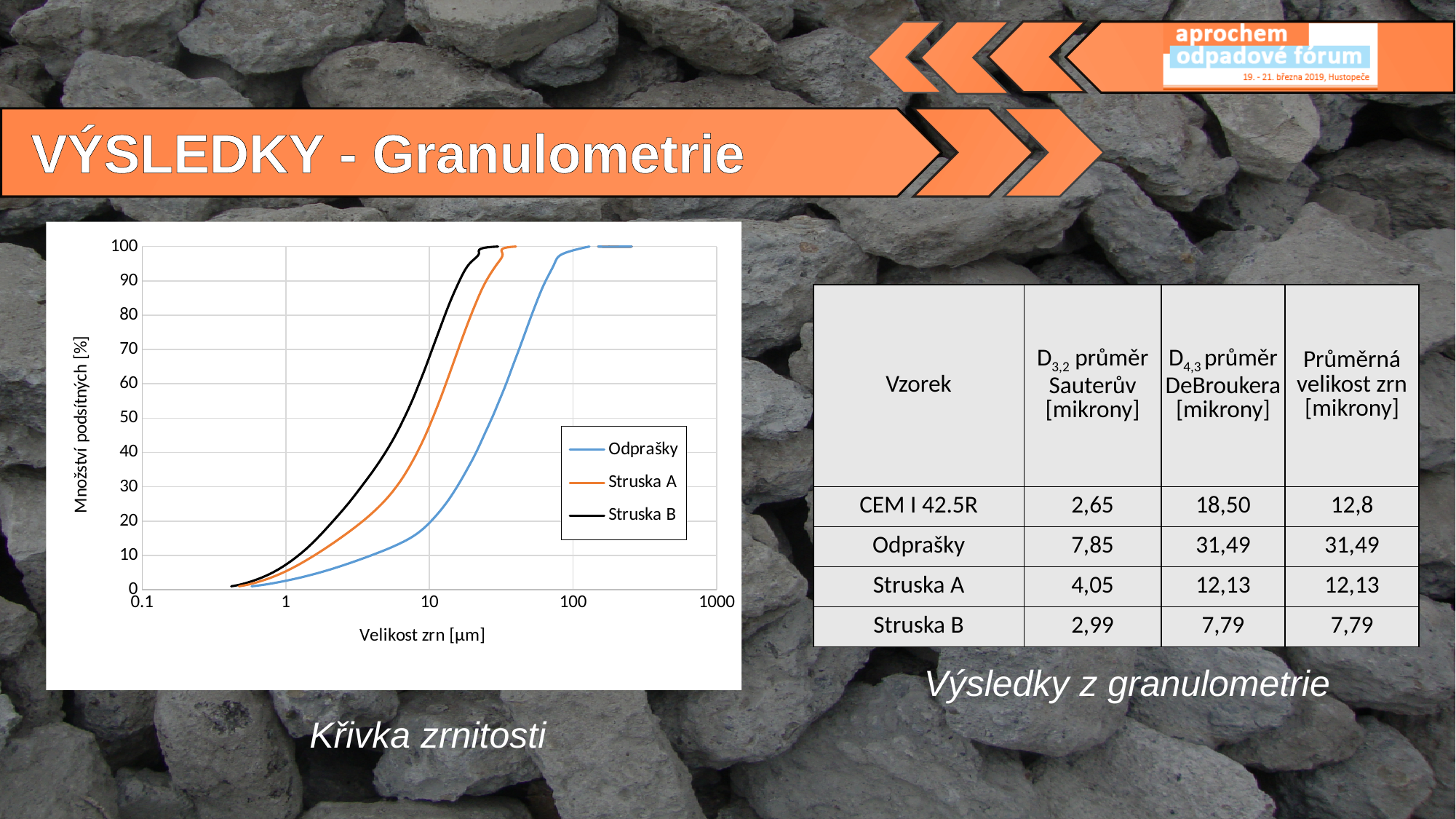
How many series does the legend of the chart list? 3 What is the maximum value shown on the y axis of the chart? 100 What is the title of the x axis of the chart? Velikost zrn [µm] At a grain size of 1 µm, is the value for Struska B greater or less than 20? less At a grain size of 10 µm, is the value for Struska B greater or less than 60? greater At a grain size of 10 µm, which series has the higher value, Struska B or Odprašky? Struska B What kind of chart is shown on the left of the slide? line chart Which series reaches 100% at the smallest grain size? Struska B Which series are listed in the chart's legend? Odprašky, Struska A, Struska B Which series lies furthest to the right in the chart, i.e. has the coarsest grains? Odprašky Do the curves in the chart rise or fall as grain size increases along the x axis? rise At a grain size of 10 µm, is the value for Odprašky greater or less than 30? less